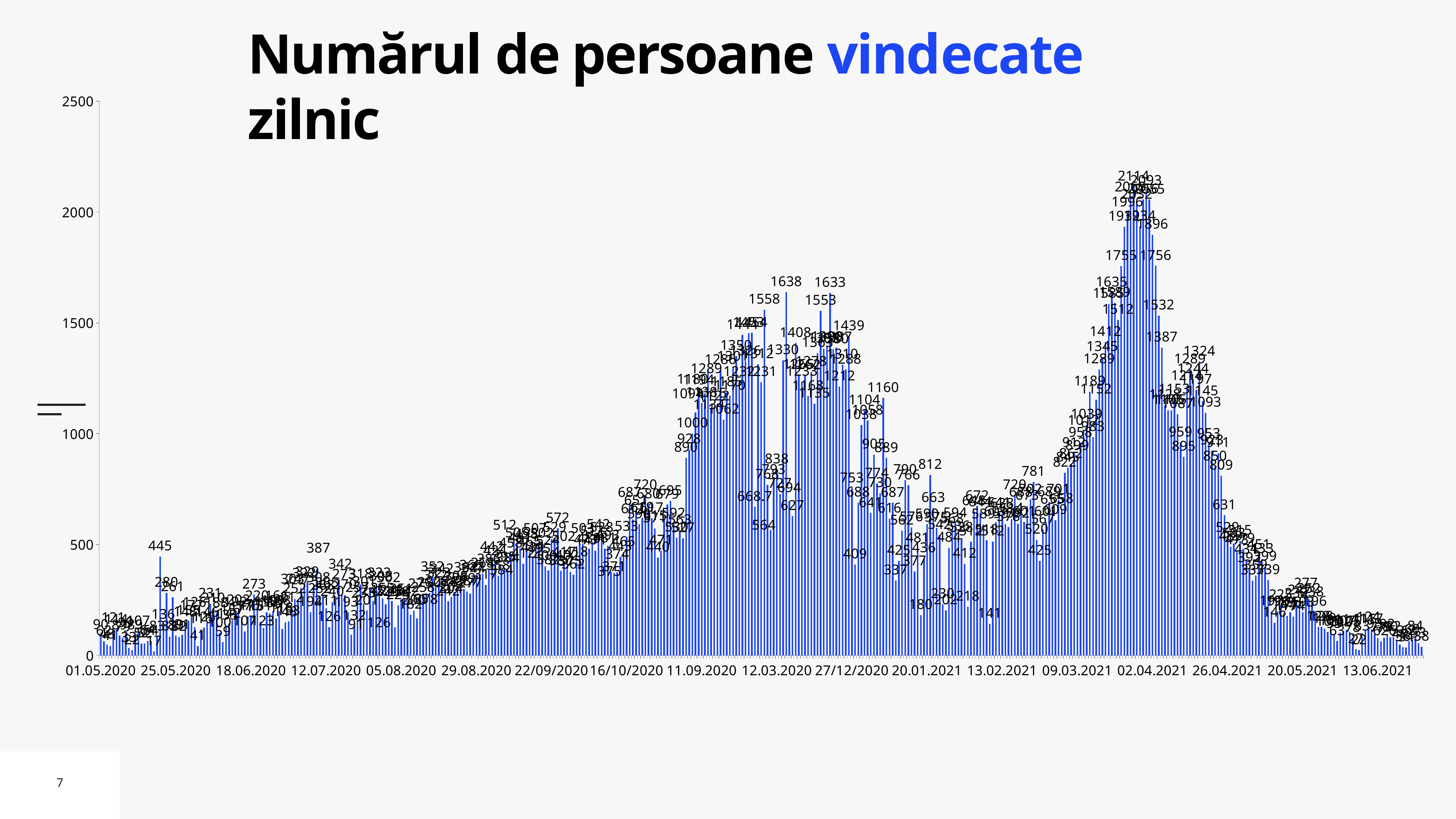
What kind of chart is shown on the slide? bar chart Is the value for the first bar at 01.05.2020 greater or less than 500? less Which is higher: the tallest bar near 02.04.2021 or the tallest bar near 12.03.2020? the tallest bar near 02.04.2021 What is the last date label on the horizontal axis? 13.06.2021 Do the values rise or fall from 02.04.2021 to 13.06.2021? fall What is the highest value shown on the vertical axis? 2500 What is the first date label on the horizontal axis? 01.05.2020 How many date labels are shown on the horizontal axis? 18 Is the tallest bar on the chart greater or less than 2000? greater What is the title of the chart? Numărul de persoane vindecate zilnic What is the difference between the highest labelled value (2114) and the labelled peak of 1638? 476 What is the highest daily value labelled on the chart? 2114